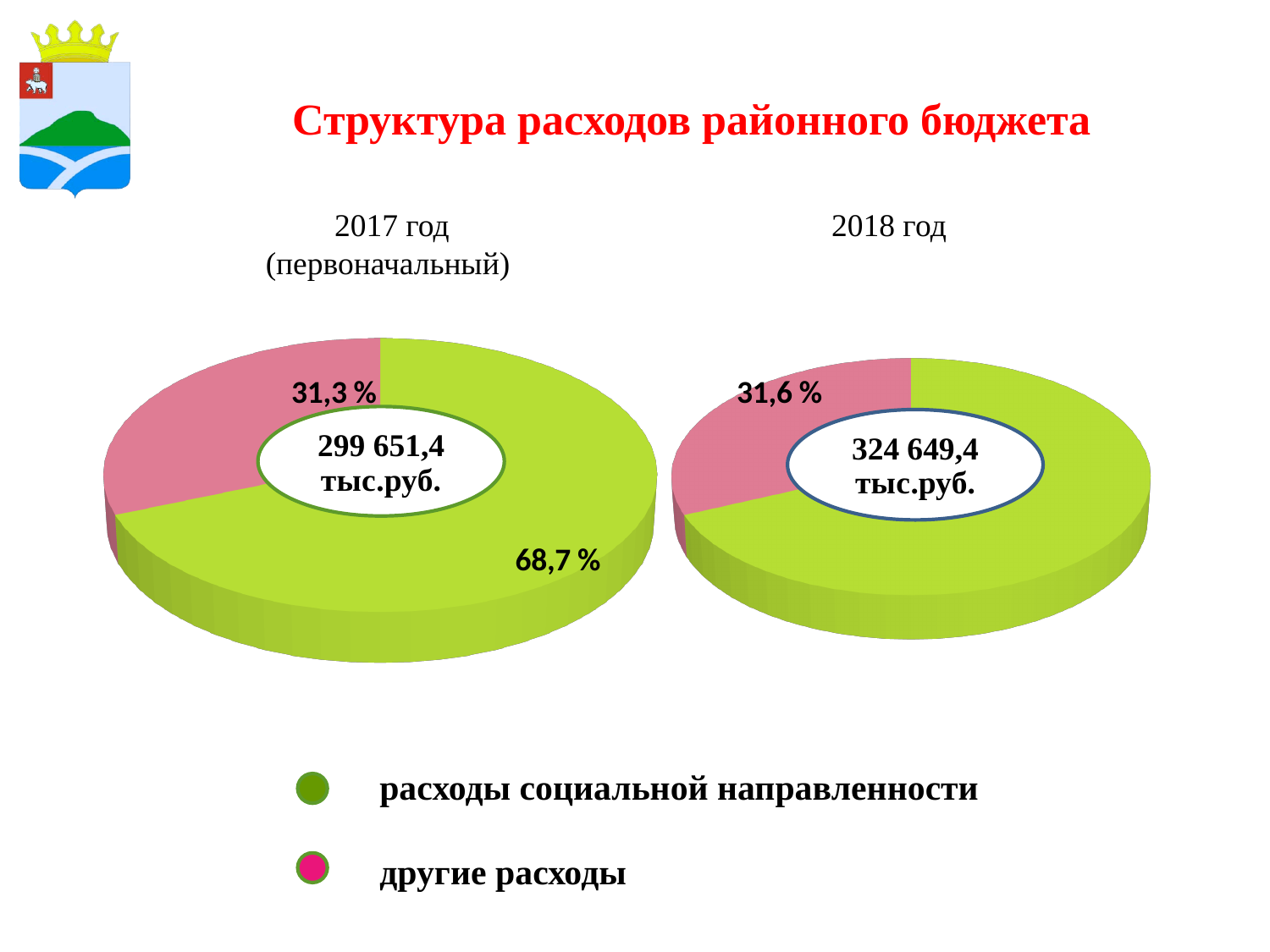
What total amount is printed in the centre of the 2018 год pie chart? 324 649,4 тыс.руб. What is the difference in percentage points between the другие расходы share in 2018 год and in 2017 год (первоначальный)? 0,3 In the 2017 год (первоначальный) pie chart, what share is shown for расходы социальной направленности? 68,7 % In the 2018 год pie chart, which category has the smallest slice? другие расходы Which year's pie chart shows a larger share for другие расходы, 2017 год (первоначальный) or 2018 год? 2018 год In the 2018 год pie chart, what share is shown for другие расходы? 31,6 % How many categories does the legend list for the pie charts? 2 In the 2017 год (первоначальный) pie chart, which category has the largest slice? расходы социальной направленности What kind of chart is used on this slide for each year? pie chart Which colour represents расходы социальной направленности in the pie charts? green In the 2017 год (первоначальный) pie chart, what share is shown for другие расходы? 31,3 % What total amount is printed in the centre of the 2017 год (первоначальный) pie chart? 299 651,4 тыс.руб.